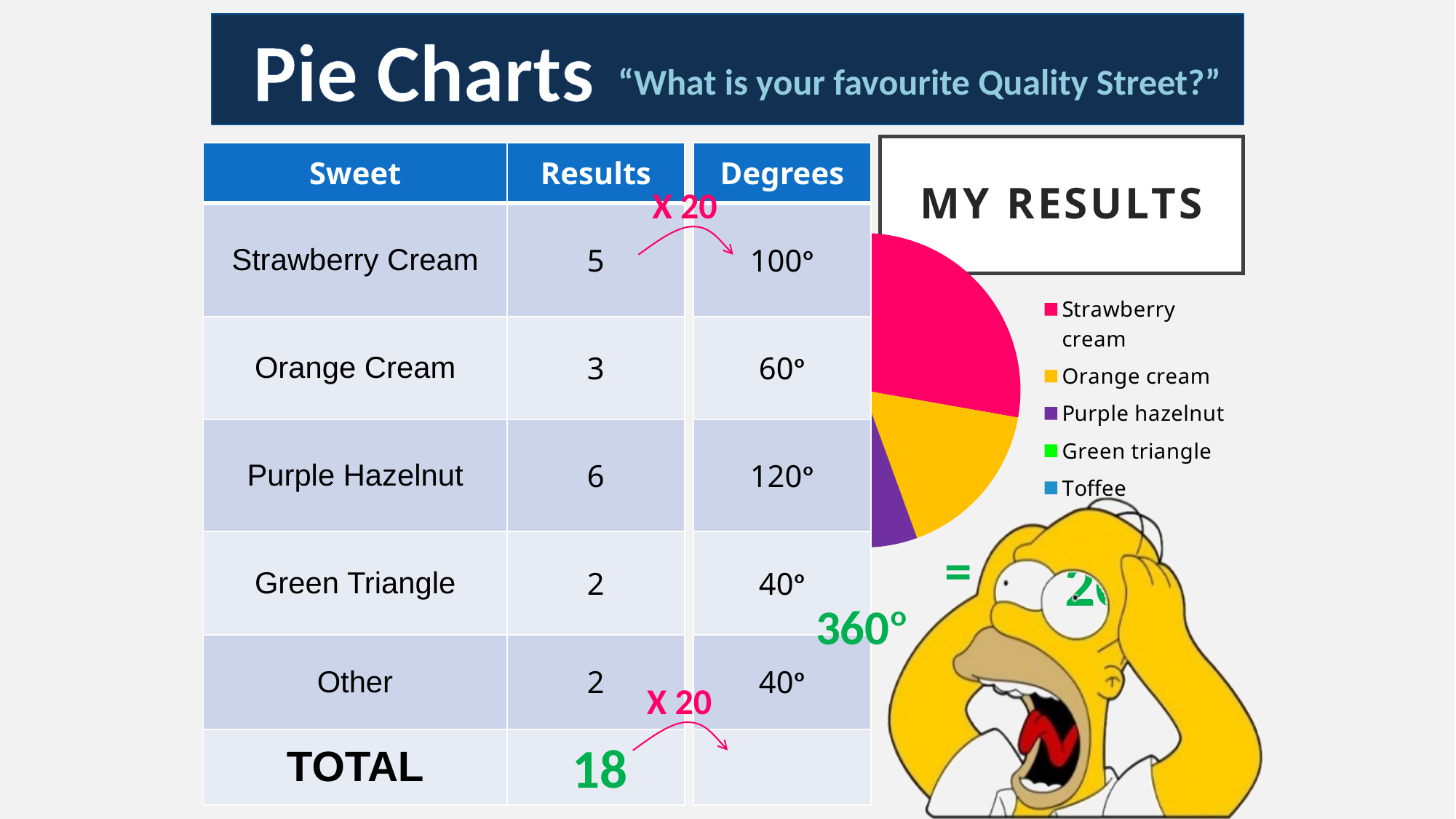
In the "MY RESULTS" pie chart legend, which entry is shown in purple? Purple hazelnut How many categories are shown in the legend of the "MY RESULTS" pie chart? 5 In the "MY RESULTS" pie chart, which slice is larger: Strawberry cream or Orange cream? Strawberry cream How many entries does the legend of the "MY RESULTS" pie chart list? 5 What is the title of the pie chart on the slide? MY RESULTS What kind of chart is shown under the title "MY RESULTS"? pie chart